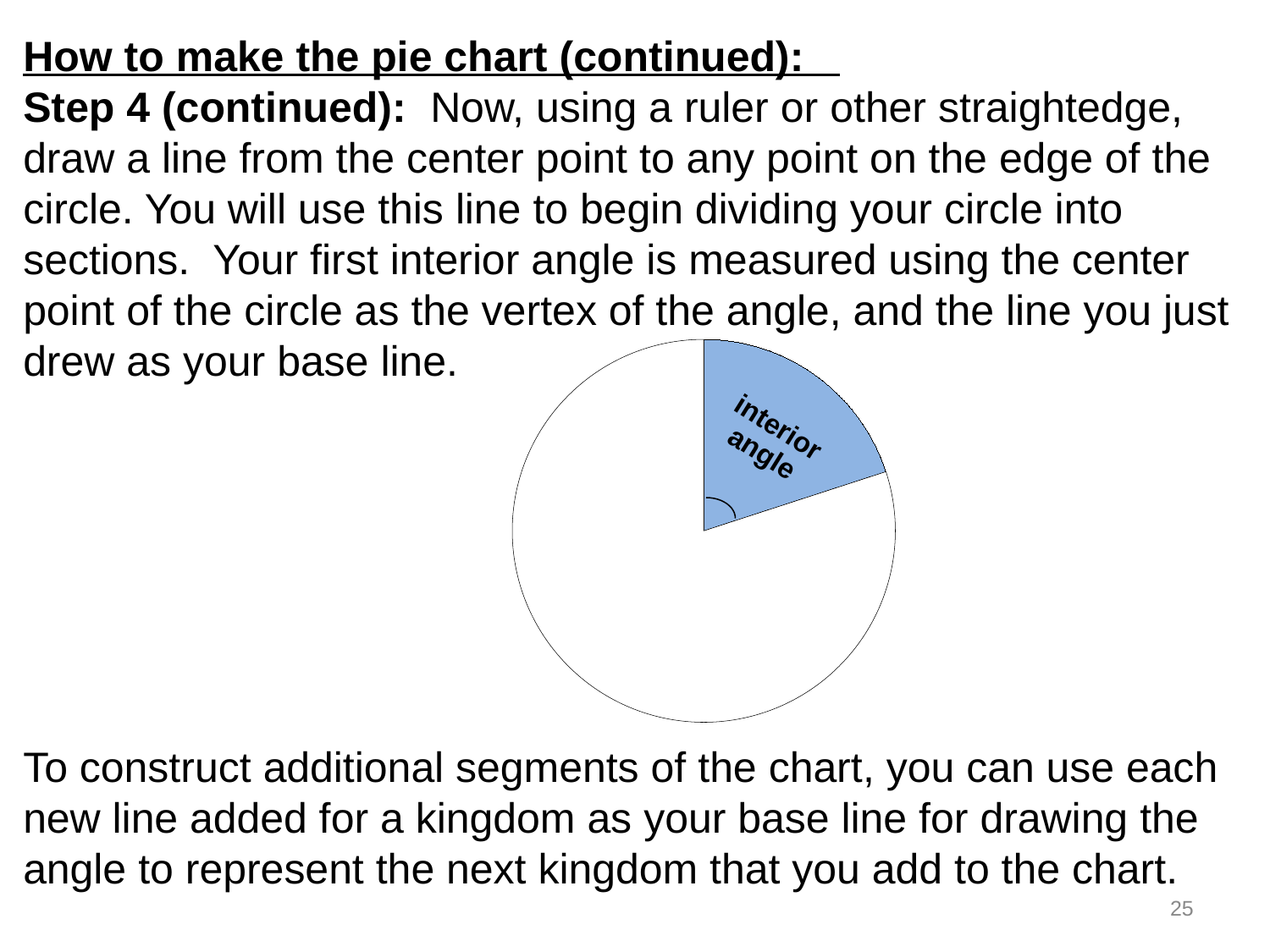
What kind of chart is shown on the slide? pie chart How many slices of the pie chart are shaded? 1 Which is larger in the pie chart, the shaded slice or the unshaded portion? the unshaded portion What colour is the shaded slice of the pie chart? blue Into how many sections is the circle divided in the pie chart? 2 What label is written inside the shaded slice of the pie chart? interior angle